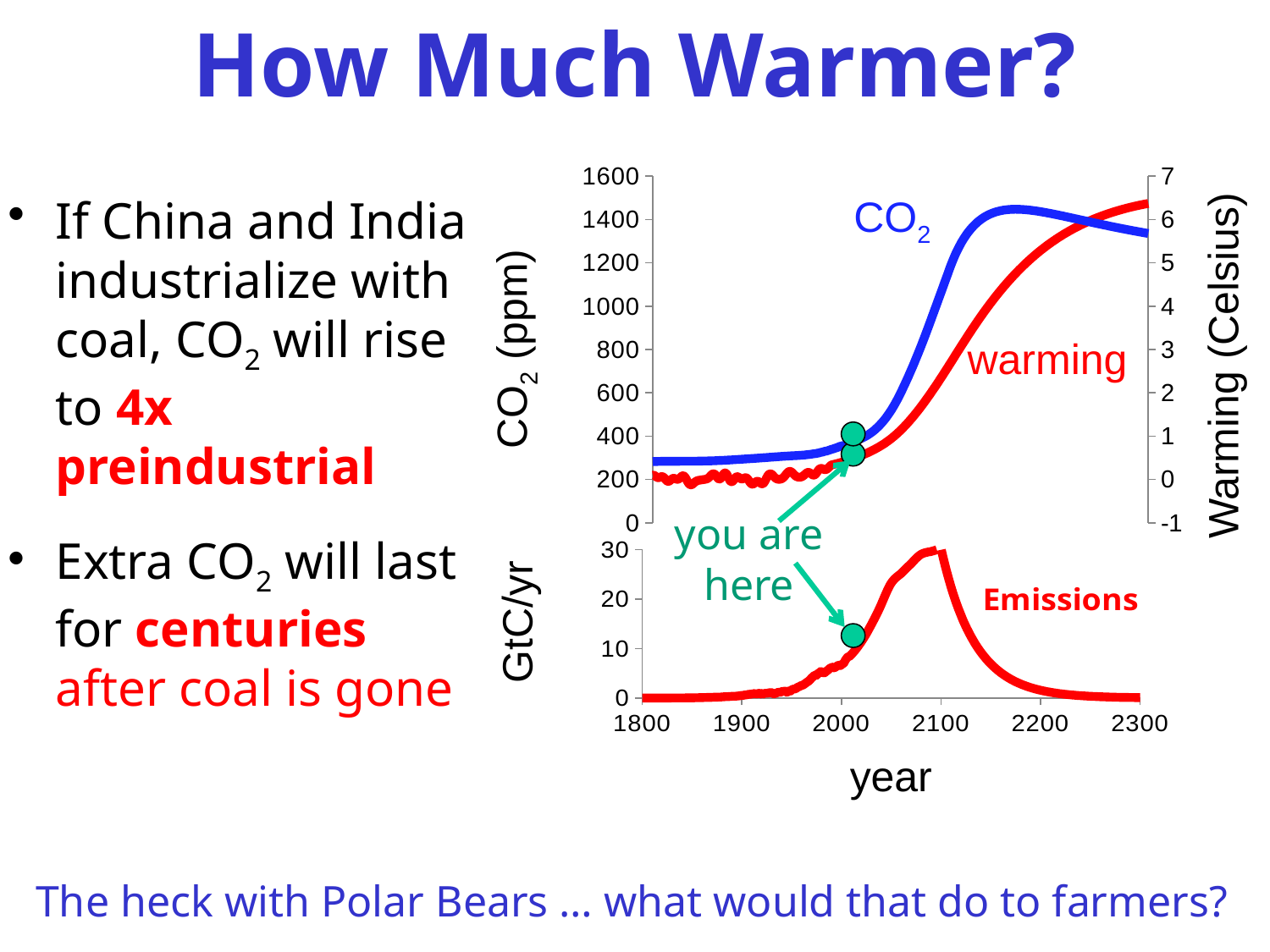
In the upper chart, is the CO2 value in 1800 greater or less than 400 ppm? less In the lower Emissions chart, is the emissions value in 2300 greater or less than 10 GtC/yr? less In the upper chart, is the peak CO2 value (around 2150-2200) greater or less than 1200 ppm? greater In the upper chart, does the CO2 line rise or fall between 1800 and 2100? rise In the lower Emissions chart, do emissions rise or fall between 2100 and 2200? fall In the lower Emissions chart, which year has higher emissions, 2000 or 2100? 2100 In the upper chart, does the CO2 line rise or fall between 2200 and 2300? fall What is the label on the right-hand vertical axis of the upper chart? Warming (Celsius) What kind of chart is the upper chart showing CO2 and warming? line chart In the upper chart, how many data series are plotted? 2